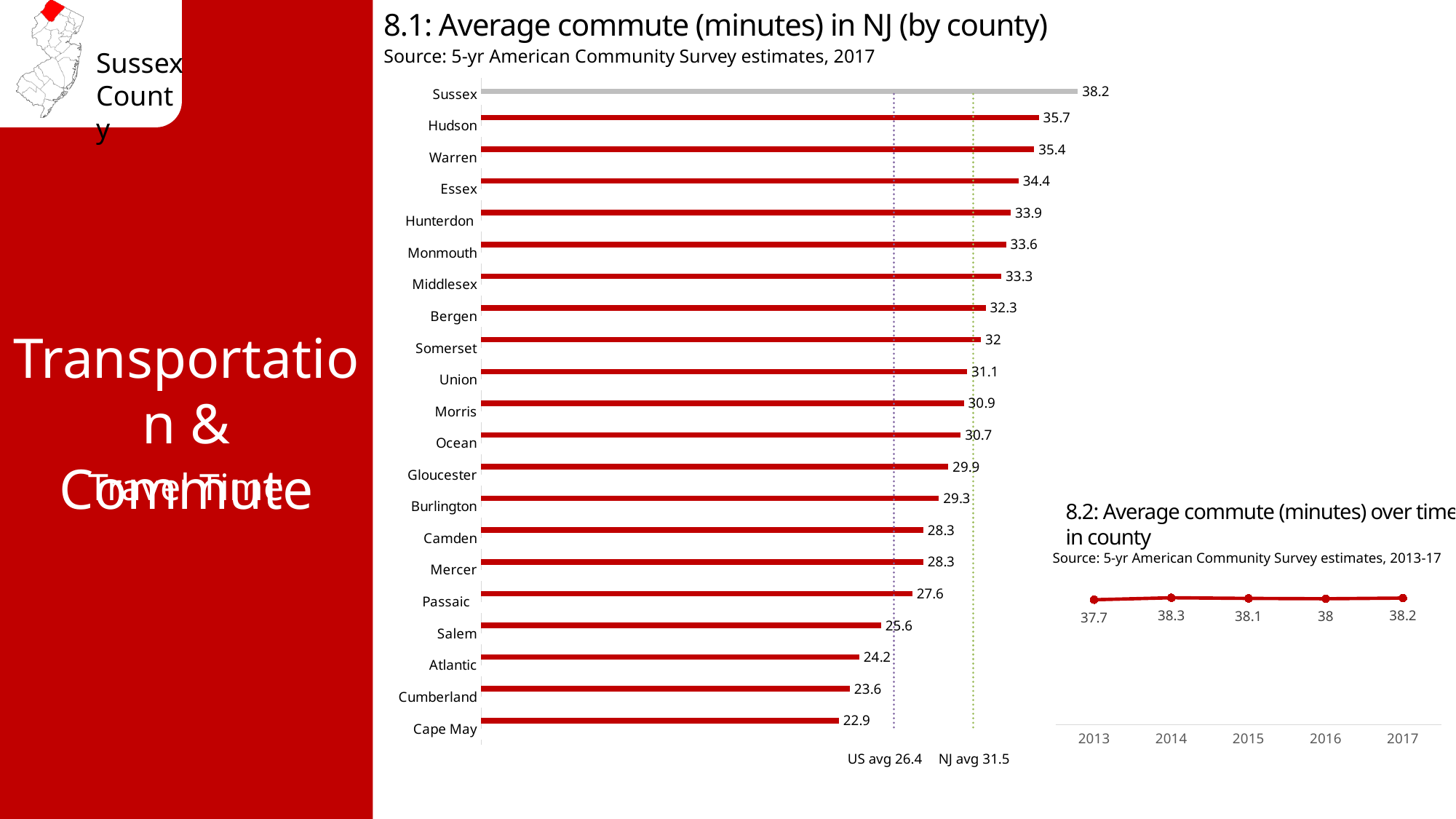
In chart 8.1 (Average commute in NJ by county), what is the NJ average commute shown by the dotted reference line? 31.5 In chart 8.2 (Average commute over time in county), which year had the highest average commute? 2014 In chart 8.1 (Average commute in NJ by county), what is the average commute for Hunterdon? 33.9 In chart 8.1 (Average commute in NJ by county), which county has the lowest average commute? Cape May In chart 8.1 (Average commute in NJ by county), what is the difference between Sussex and Hudson? 2.5 In chart 8.1 (Average commute in NJ by county), which has a longer average commute, Warren or Essex? Warren What kind of chart is chart 8.2 (Average commute over time in county)? Line chart In chart 8.1 (Average commute in NJ by county), which county has the highest average commute? Sussex In chart 8.1 (Average commute in NJ by county), how many counties are shown? 21 In chart 8.2 (Average commute over time in county), what was the average commute in 2013? 37.7 What kind of chart is chart 8.1 (Average commute in NJ by county)? Bar chart In chart 8.1 (Average commute in NJ by county), what is the average commute for Sussex? 38.2